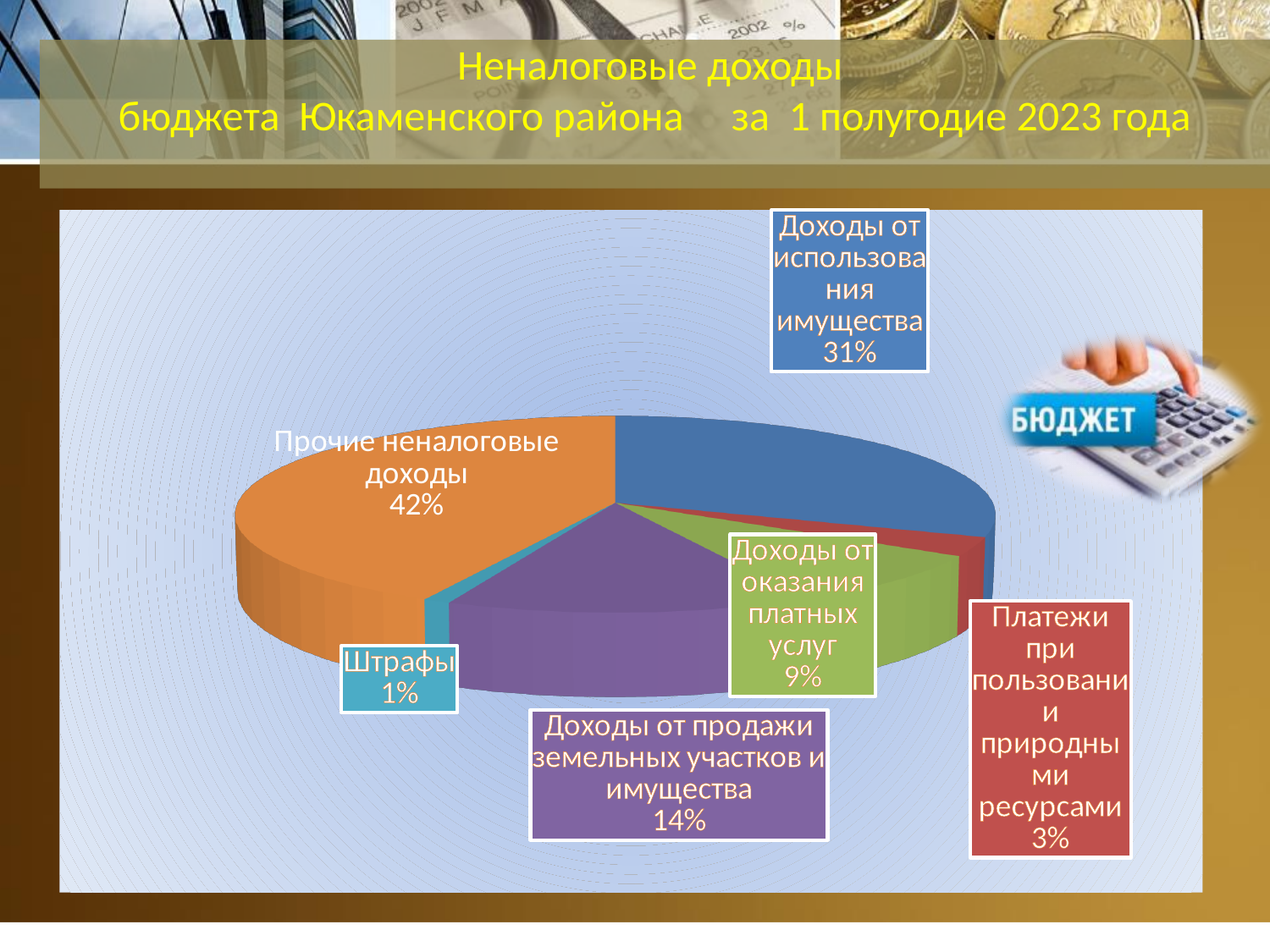
What percentage is labelled for "Штрафы"? 1% What share of the pie does "Прочие неналоговые доходы" hold? 42% What is the value shown for "Доходы от использования имущества"? 31% What is the difference in percentage points between "Прочие неналоговые доходы" and "Доходы от использования имущества"? 11 Which category has the smallest share of the pie? Штрафы What colour is the slice for "Доходы от использования имущества"? Blue What is the combined share of "Доходы от оказания платных услуг" and "Платежи при пользовании природными ресурсами"? 12% What type of chart is shown on the slide? Pie chart Which is larger: "Доходы от оказания платных услуг" or "Платежи при пользовании природными ресурсами"? Доходы от оказания платных услуг What is the value for "Доходы от продажи земельных участков и имущества"? 14% Which category has the largest share of the pie? Прочие неналоговые доходы How many categories (slices) does the pie chart show? 6